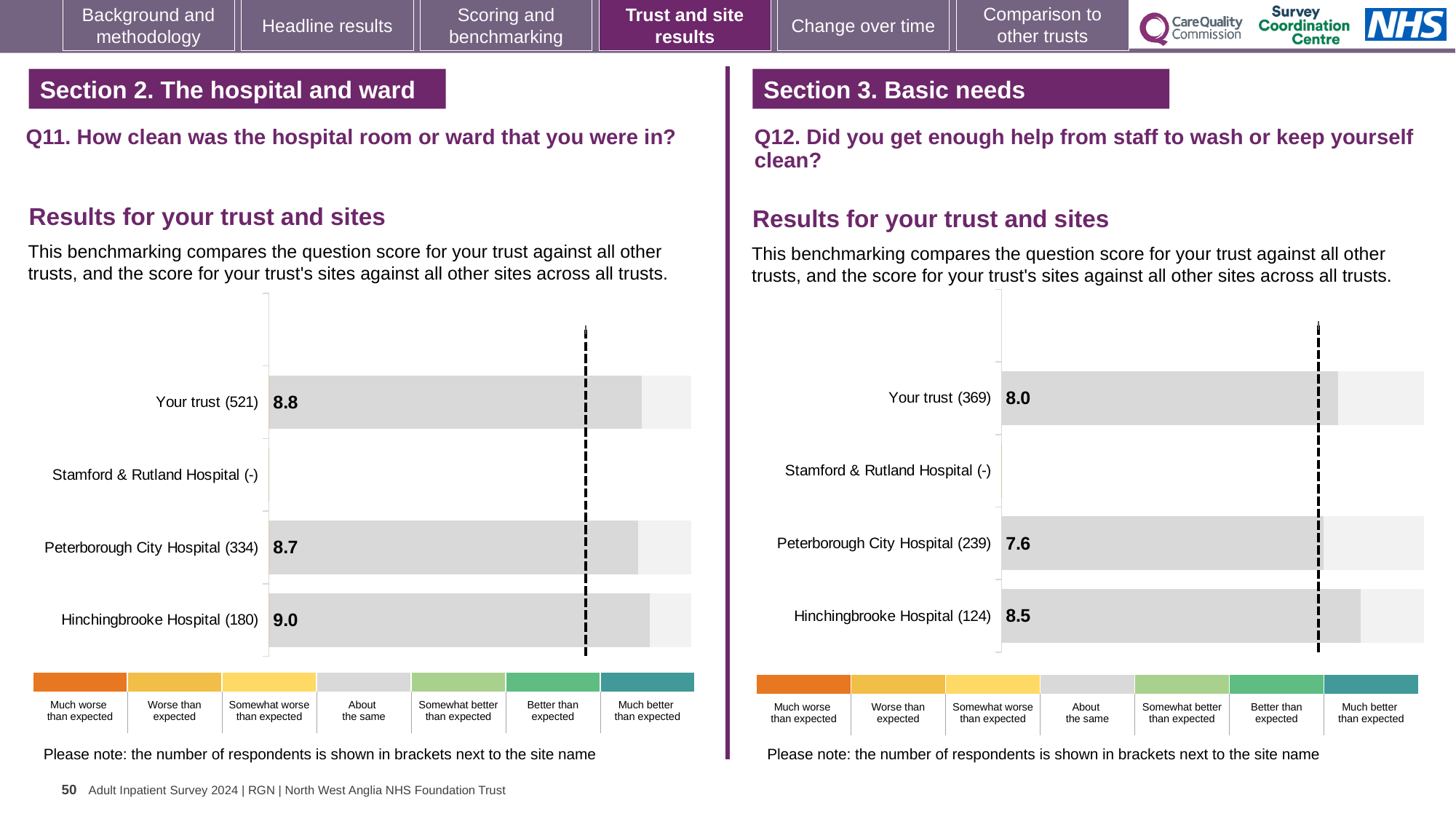
On the Q12 chart (right), what is the difference between the scores for Hinchingbrooke Hospital and Your trust? 0.5 On the Q11 chart (left), what is the score for Hinchingbrooke Hospital? 9.0 On the Q11 chart (left), how many respondents are shown in brackets for Peterborough City Hospital? 334 On the Q12 chart (right), which is larger: the score for Hinchingbrooke Hospital or the score for Your trust? Hinchingbrooke Hospital On the Q11 chart (left), which site has the highest score? Hinchingbrooke Hospital On the Q12 chart (right), what is the score for Your trust? 8.0 On the Q11 chart (left), what is the score for Your trust? 8.8 On the Q12 chart (right), which site has the lowest score? Peterborough City Hospital On the Q11 chart (left), what is the difference between the scores for Hinchingbrooke Hospital and Peterborough City Hospital? 0.3 On the Q12 chart (right), how many respondents are shown in brackets for Your trust? 369 On the Q12 chart (right), what is the score for Peterborough City Hospital? 7.6 What kind of chart is used on the Q11 chart (left)? Bar chart